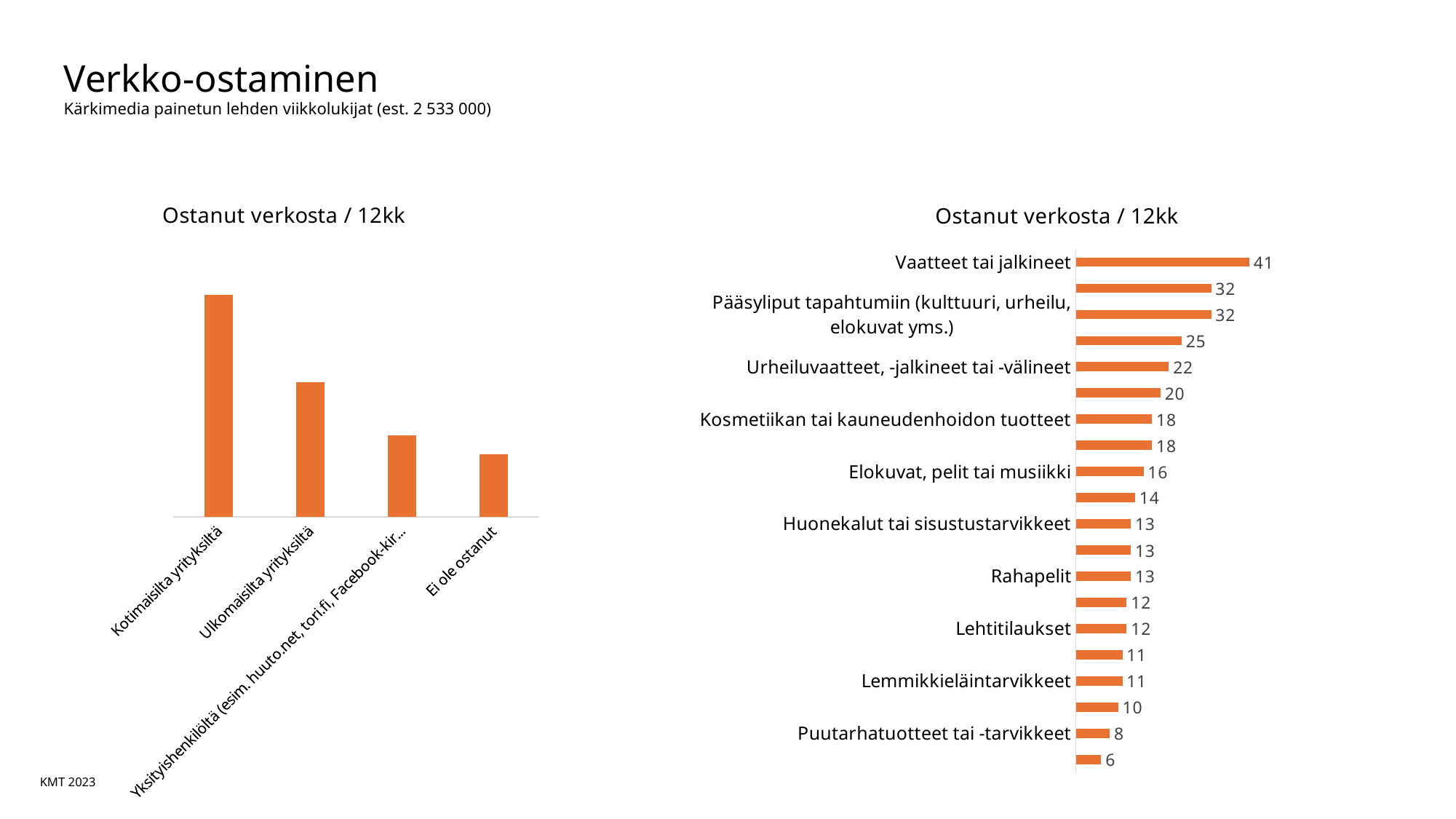
On the right-hand chart, what is the difference between Vaatteet tai jalkineet and Puutarhatuotteet tai -tarvikkeet? 33 How many bars does the right-hand chart have? 20 On the right-hand chart, what is the value for Lemmikkieläintarvikkeet? 11 On the left-hand chart, which category has the tallest bar? Kotimaisilta yrityksiltä What is the title of the right-hand chart? Ostanut verkosta / 12kk What type of chart is the left-hand chart? Bar chart On the right-hand chart, which category has the highest value? Vaatteet tai jalkineet On the right-hand chart, what is the smallest value shown? 6 On the right-hand chart, which is larger: Kosmetiikan tai kauneudenhoidon tuotteet or Elokuvat, pelit tai musiikki? Kosmetiikan tai kauneudenhoidon tuotteet On the right-hand chart, what is the value for Urheiluvaatteet, -jalkineet tai -välineet? 22 On the right-hand chart, what is the value for Vaatteet tai jalkineet? 41 On the left-hand chart, which category has the shortest bar? Ei ole ostanut